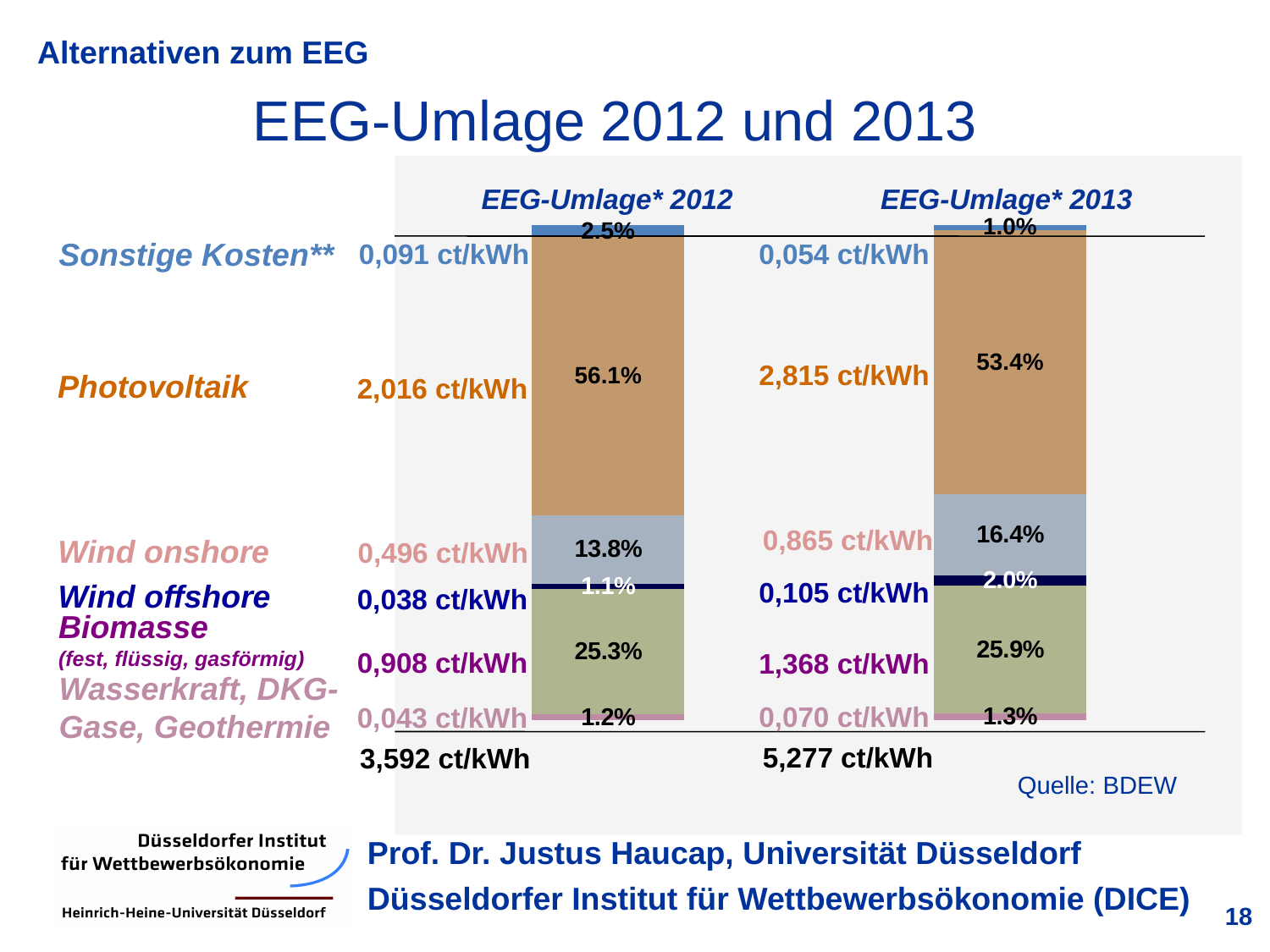
What is the percentage share of Sonstige Kosten in the EEG-Umlage 2012 bar? 2.5% What is the total of the EEG-Umlage 2012 bar? 3,592 ct/kWh What is the total of the EEG-Umlage 2013 bar? 5,277 ct/kWh What is the value for Photovoltaik in the EEG-Umlage 2012 bar? 2,016 ct/kWh What kind of chart is shown on the slide? Stacked bar chart Which component has the smallest share in the EEG-Umlage 2013 bar? Sonstige Kosten What percentage share does Wind onshore have in the EEG-Umlage 2013 bar? 16.4% What is the value for Biomasse in the EEG-Umlage 2012 bar? 0,908 ct/kWh Is the value for Wind offshore larger in 2012 or in 2013? 2013 How many bars are shown in the chart? 2 What is the value for Photovoltaik in the EEG-Umlage 2013 bar? 2,815 ct/kWh Which component has the largest share in the EEG-Umlage 2012 bar? Photovoltaik